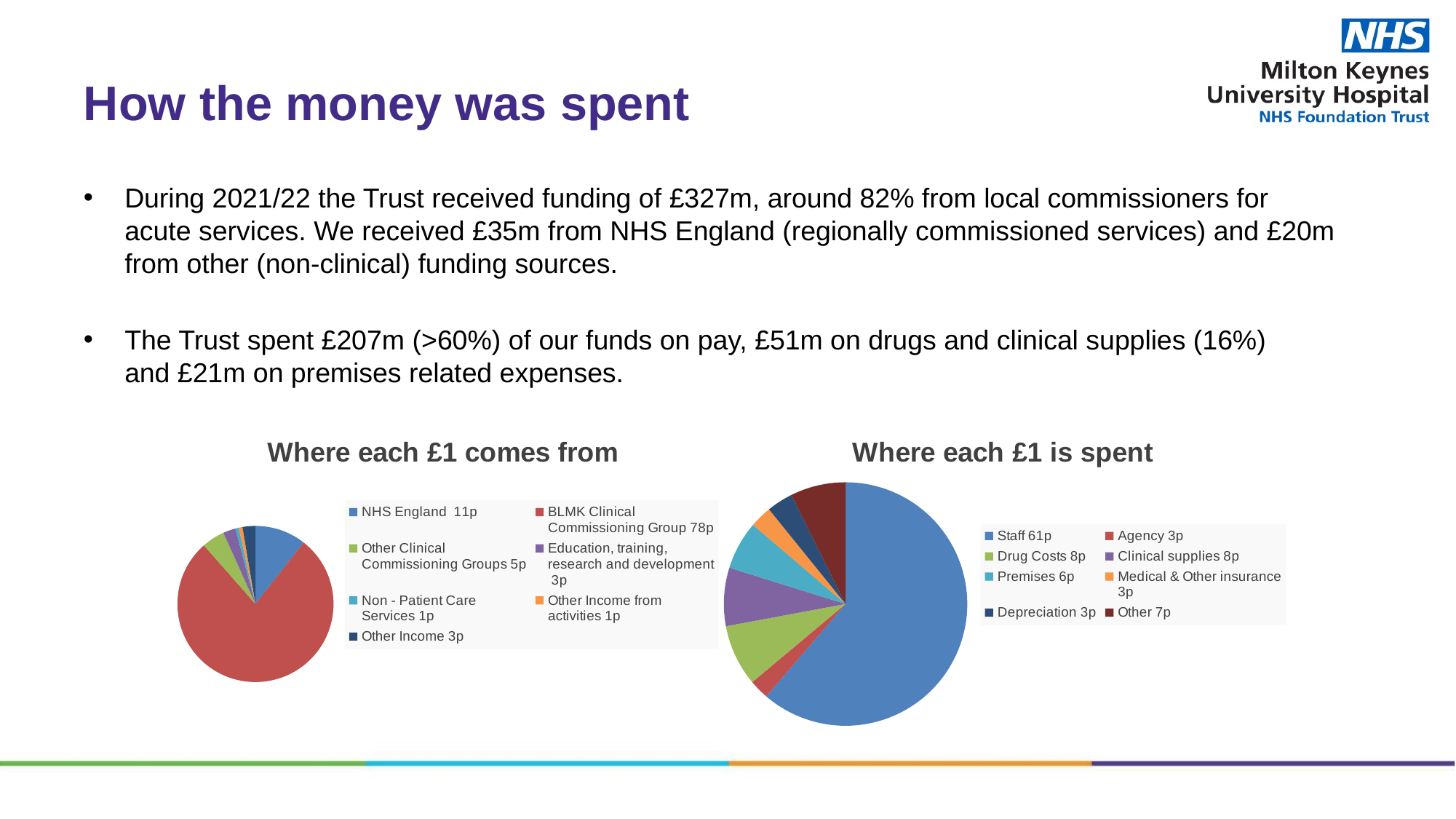
How many categories does the 'Where each £1 comes from' chart show? 7 In the 'Where each £1 is spent' chart, which category has the largest share? Staff In the 'Where each £1 is spent' chart, what is the difference between Staff and Drug Costs? 53p In the 'Where each £1 comes from' chart, what is the value for NHS England? 11p In the 'Where each £1 is spent' chart, what is the value for Other? 7p How many categories does the 'Where each £1 is spent' chart show? 8 In the 'Where each £1 comes from' chart, what is the value for BLMK Clinical Commissioning Group? 78p In the 'Where each £1 comes from' chart, which category has the largest share? BLMK Clinical Commissioning Group What type of chart is 'Where each £1 is spent'? Pie chart In the 'Where each £1 comes from' chart, which is larger: NHS England or Other Clinical Commissioning Groups? NHS England In the 'Where each £1 is spent' chart, what is the value for Premises? 6p In the 'Where each £1 is spent' chart, what is the value for Staff? 61p